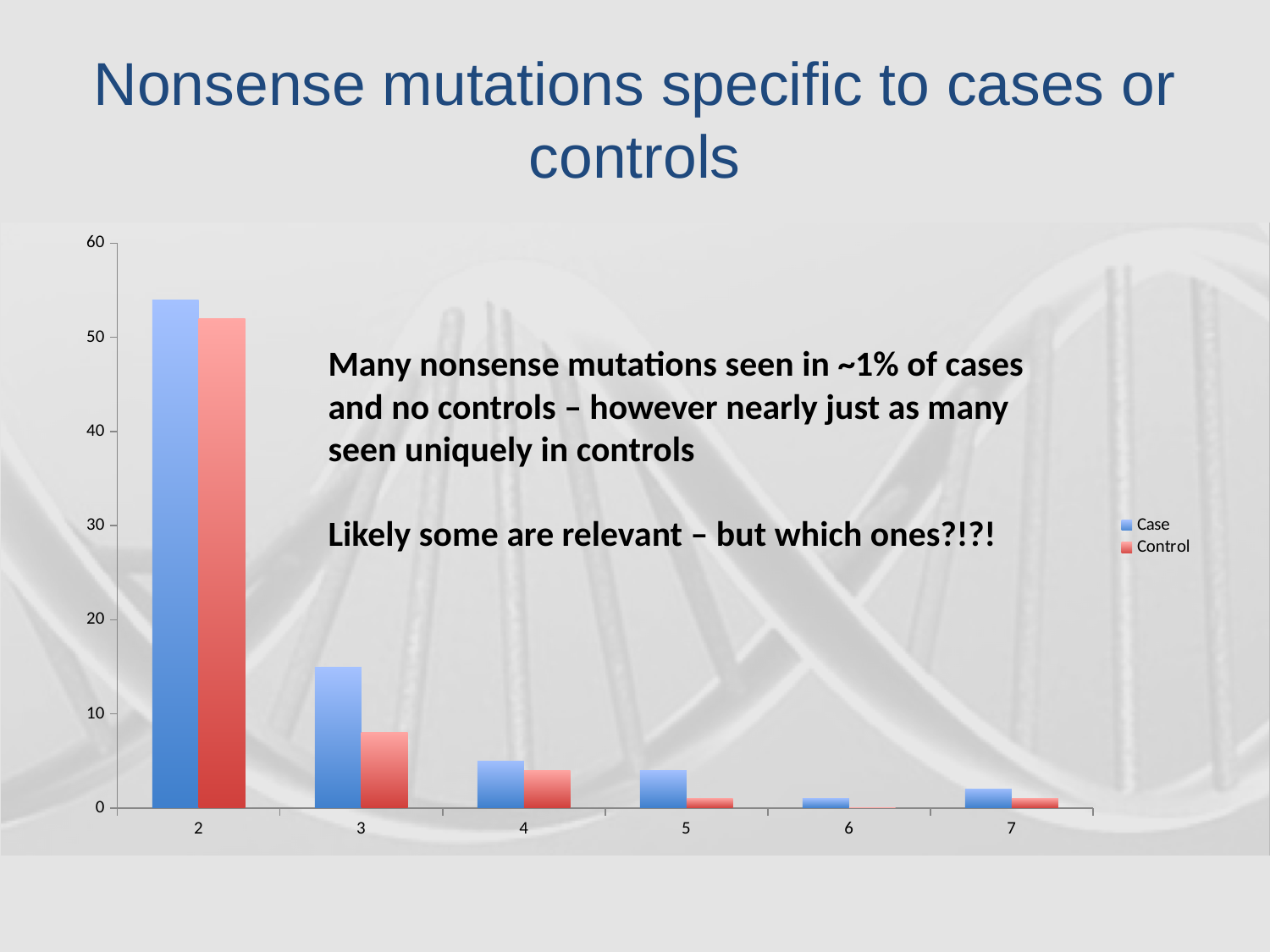
For category 3, which is larger, Case or Control? Case Which category has the highest Control value? 2 Which category has the lowest Control value? 6 How many series does the legend list? 2 Which category has the highest Case value? 2 What kind of chart is shown on the slide? bar chart Do the Case values generally rise or fall from category 2 to category 6? fall How many categories are shown on the x axis? 6 Is the Case value for category 2 greater or less than 50? greater What are the two series named in the legend? Case and Control Is the Case value for category 3 greater or less than 10? greater Is the Control value for category 3 greater or less than 10? less